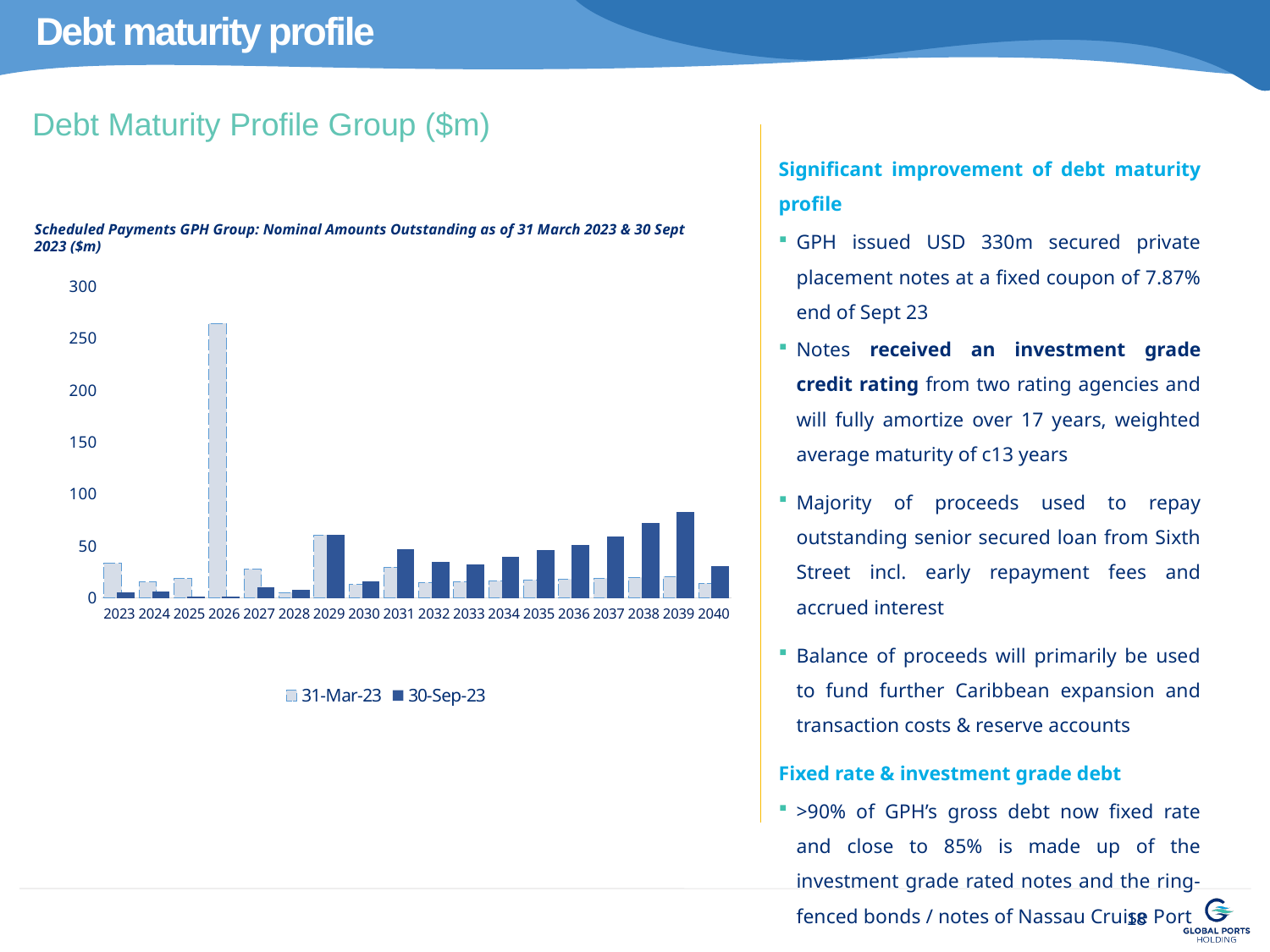
For 2038, which series has the larger value, 31-Mar-23 or 30-Sep-23? 30-Sep-23 Which year has the highest 30-Sep-23 value? 2039 Which year has the highest 31-Mar-23 value? 2026 Is the 30-Sep-23 value for 2039 greater or less than 50? greater For 2026, which series has the larger value, 31-Mar-23 or 30-Sep-23? 31-Mar-23 How many years are shown on the x axis of the chart? 18 What kind of chart is shown on the slide? Bar chart How many series does the chart legend list? 2 What are the two legend entries of the chart? 31-Mar-23 and 30-Sep-23 From 2033 to 2039, do the 30-Sep-23 values generally rise or fall? rise Is the 31-Mar-23 value for 2023 greater or less than 50? less Is the 31-Mar-23 value for 2026 greater or less than 250? greater